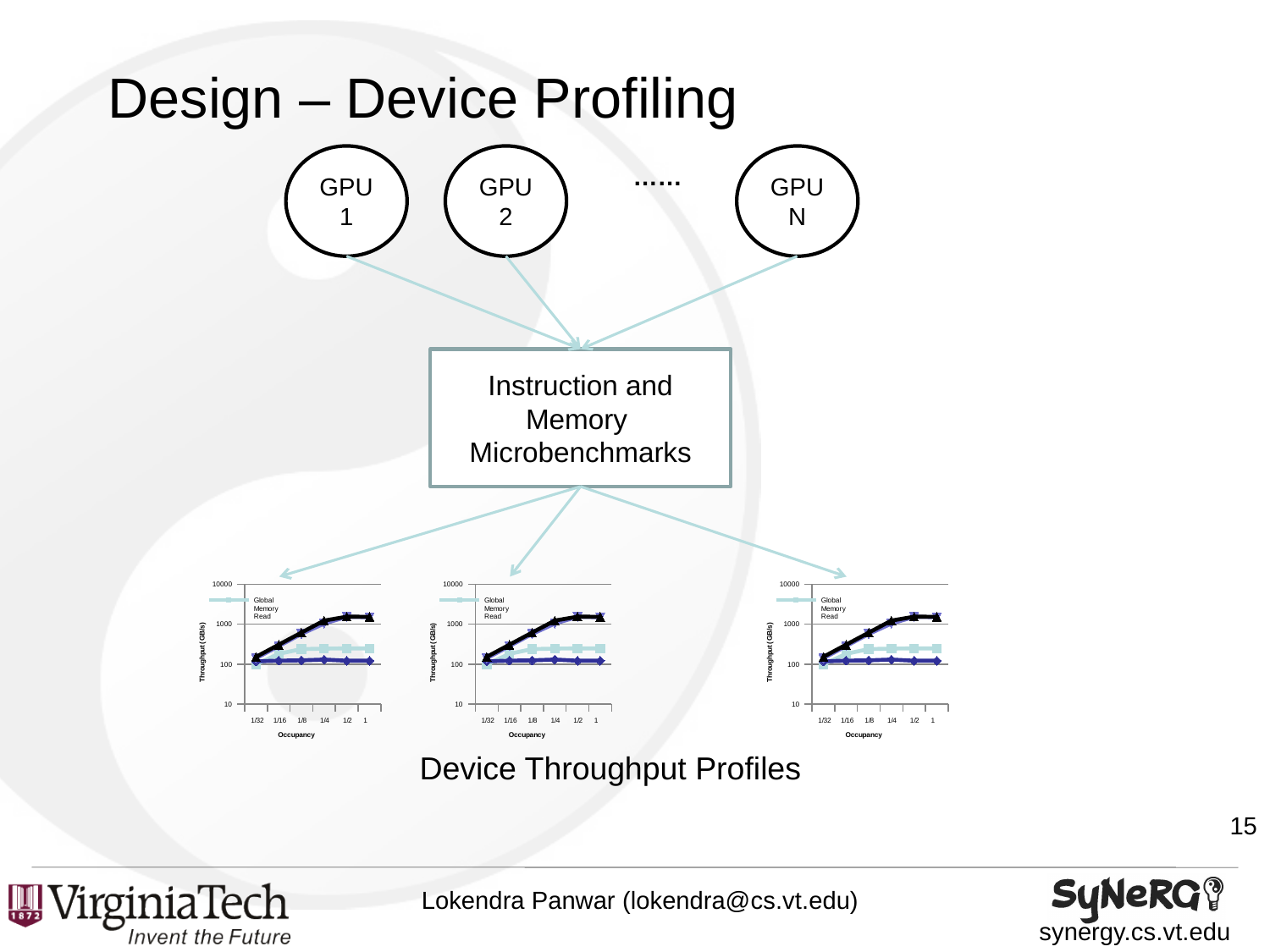
In the right chart, is the value of the black triangle series at occupancy 1 greater or less than 1000? greater In the left chart, what is the highest tick value shown on the y axis? 10000 In the left chart, does the black triangle series rise or fall as occupancy increases from 1/32 to 1/2? rise In the middle chart, what is the label of the x axis? Occupancy In the left chart, how many occupancy values are marked on the x axis? 6 In the left chart, is the value of the black triangle series at occupancy 1/32 greater or less than 1000? less What kind of chart is the left chart under the Microbenchmarks box? line chart In the middle chart, what is the lowest occupancy value shown on the x axis? 1/32 In the middle chart, is the value of the light blue square series at occupancy 1 greater or less than 1000? less In the left chart, what is the label of the y axis? Throughput (GB/s) How many throughput profile charts are shown on the slide? 3 In the right chart, which series is higher at occupancy 1/2, the black triangle series or the light blue square series? black triangle series